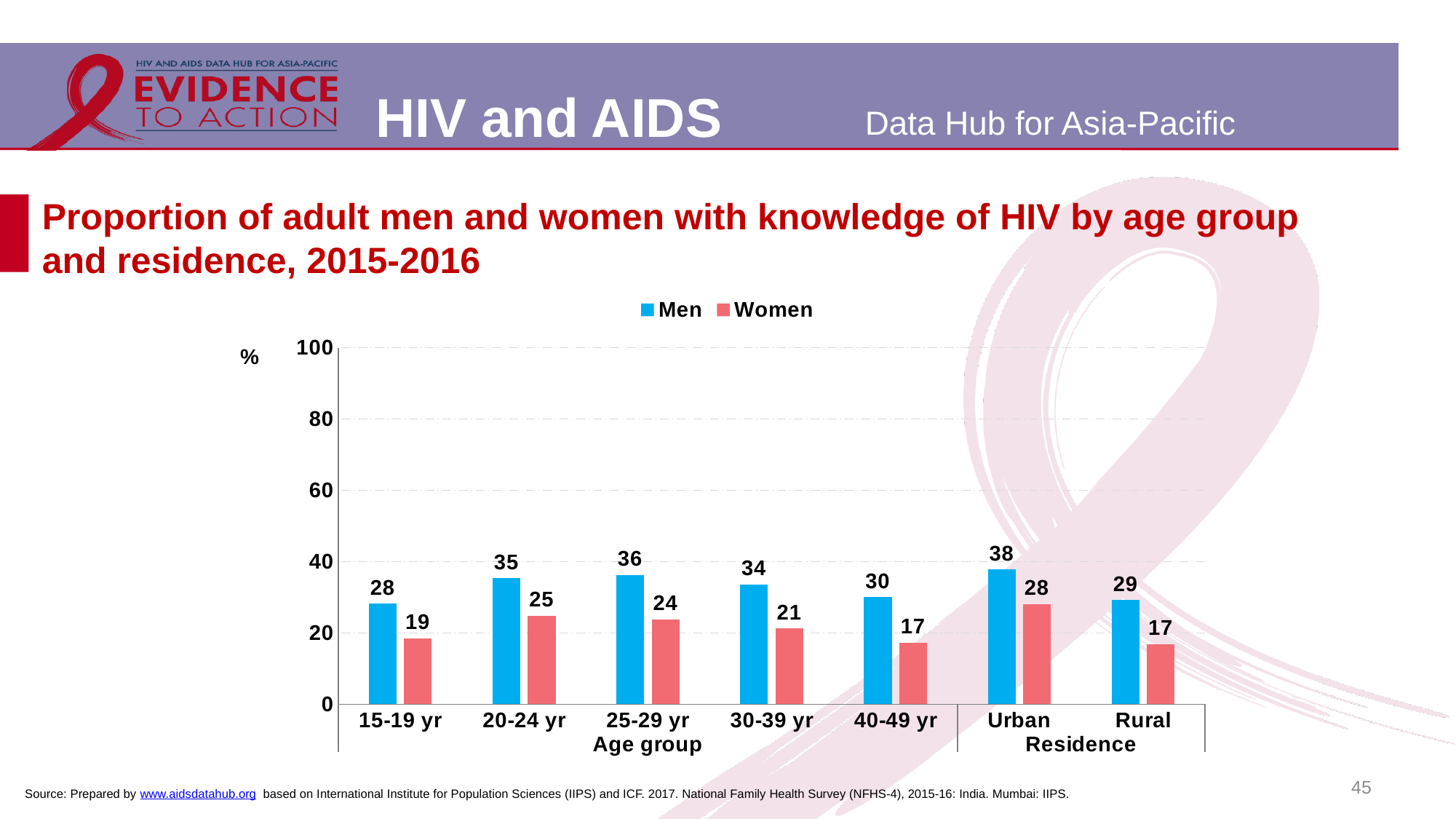
What is the value for Women in the 40-49 yr age group? 17 Which is larger, the Men value for Urban or the Men value for Rural? Urban Which category has the highest value for Men? Urban How many categories are shown on the x axis? 7 How many series does the legend list? 2 What is the value for Women in the Urban residence category? 28 Is the value for Men in the 25-29 yr age group greater or less than 40? less Which category has the lowest value for Women? 40-49 yr and Rural (both 17) What is the difference between the Men and Women values for the 30-39 yr age group? 13 What is the value for Men in the 15-19 yr age group? 28 What kind of chart is shown on the slide? Bar chart Which colour represents Women in the chart? Red (pink)